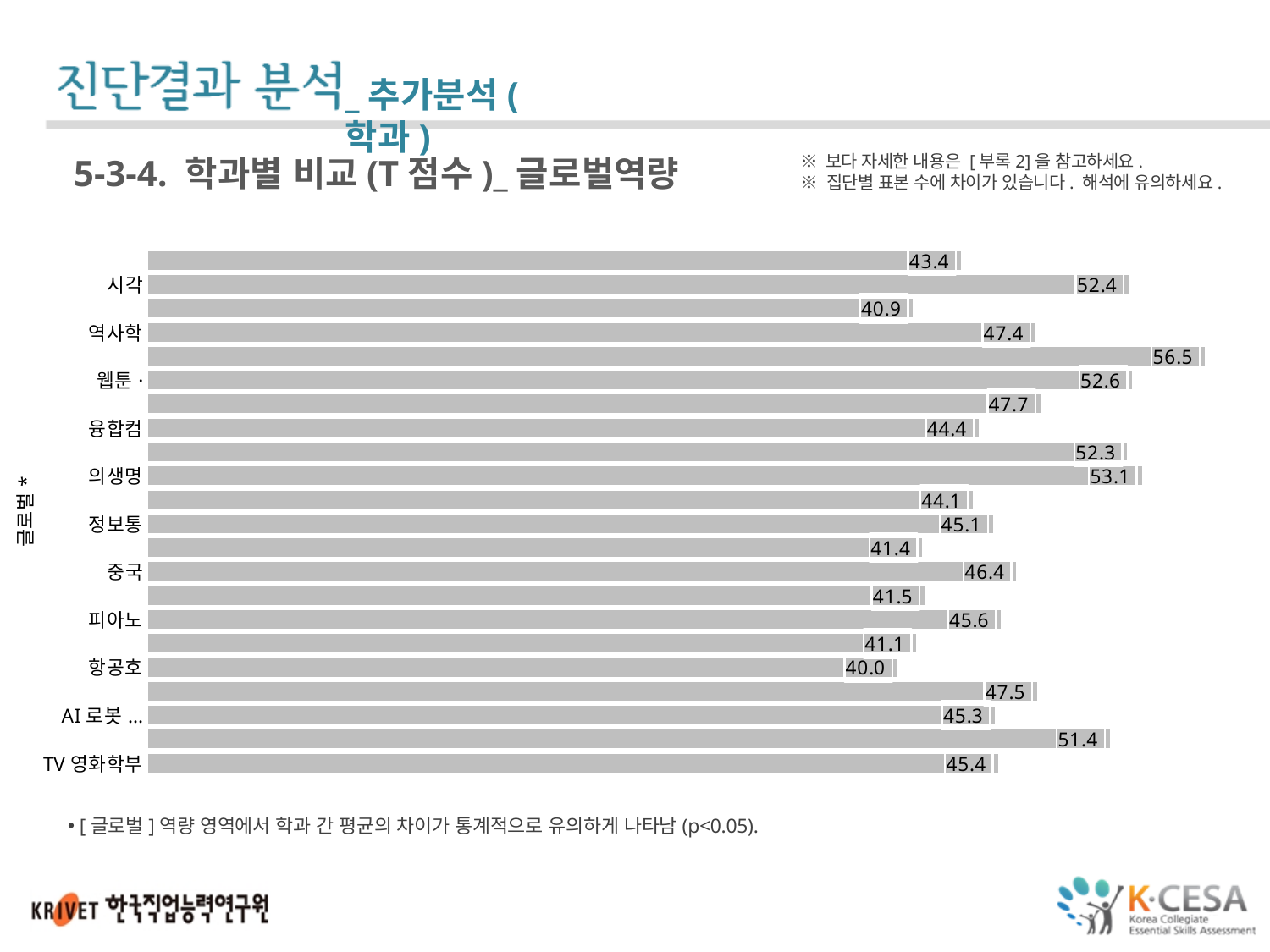
What is the difference between the highest value (56.5) and the lowest value (40.0) on the chart? 16.5 How many bars are plotted on the chart? 22 Which is larger: the topmost bar (43.4) or the second bar from the top (52.4)? the second bar from the top (52.4) What is the value of the second bar from the bottom of the chart? 51.4 What is the lowest value shown on the bar chart? 40.0 What kind of chart is shown on the slide? bar chart What is the highest value shown on the bar chart? 56.5 How many bars on the chart have a value above 50? 6 What is the value of the topmost bar on the chart? 43.4 What is the title of the chart section on the slide? 5-3-4. 학과별 비교(T 점수)_글로벌역량 What is the value of the bar aligned with the label 역사학? 47.4 What is the value of the bar labelled TV 영화학부? 45.4